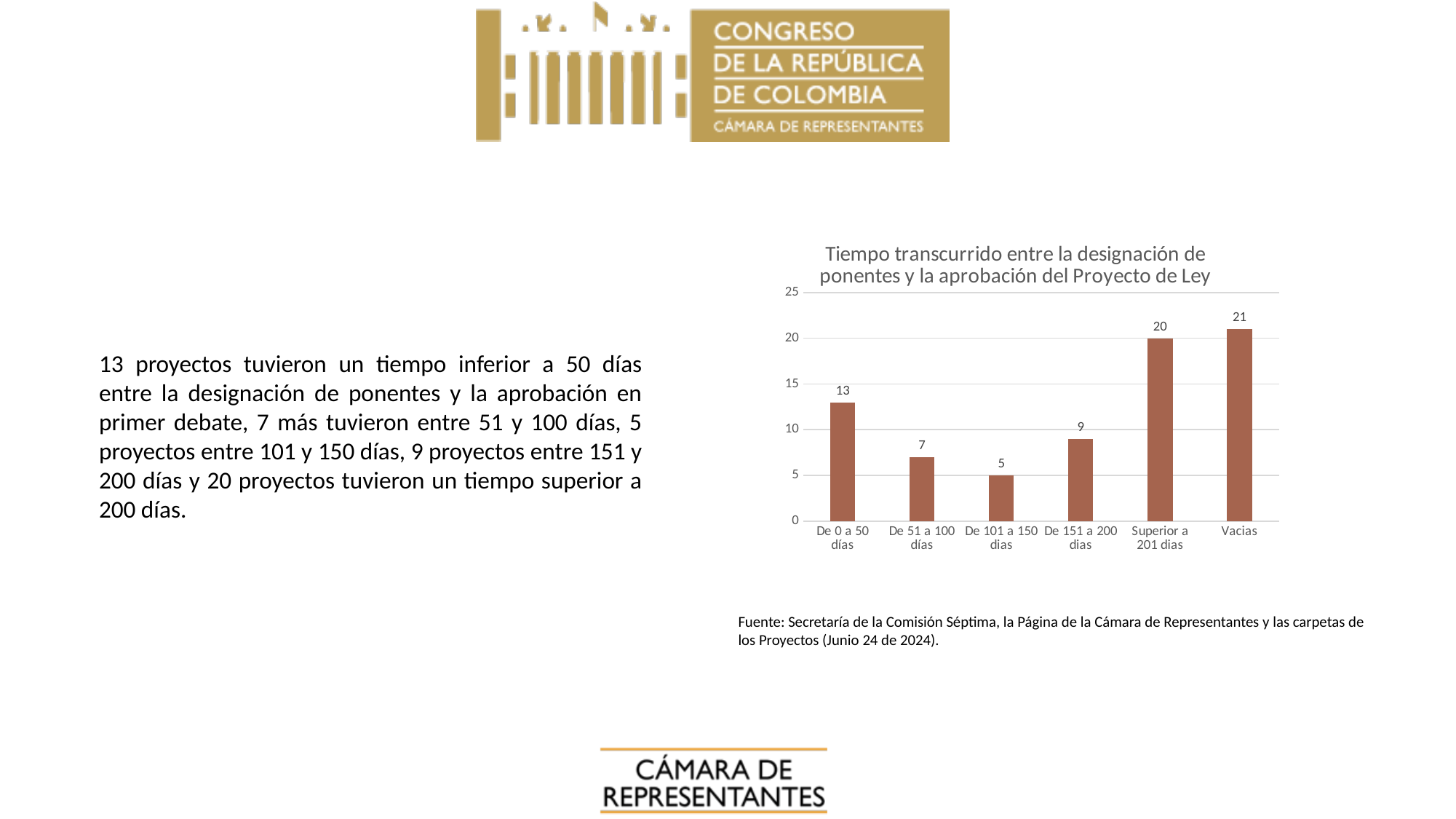
What kind of chart is shown on the slide? bar chart What is the value for 'De 51 a 100 días'? 7 What is the value for 'De 0 a 50 días'? 13 What is the title of the chart? Tiempo transcurrido entre la designación de ponentes y la aprobación del Proyecto de Ley Which category has the highest value? Vacias What is the value for 'Superior a 201 dias'? 20 What is the difference between the values for 'De 151 a 200 dias' and 'De 101 a 150 dias'? 4 Which category has the lowest value? De 101 a 150 dias Is the value for 'Superior a 201 dias' greater or less than 15? greater Which is larger, the value for 'De 0 a 50 días' or the value for 'De 151 a 200 dias'? De 0 a 50 días How many categories are shown on the x axis? 6 What is the value for 'Vacias'? 21